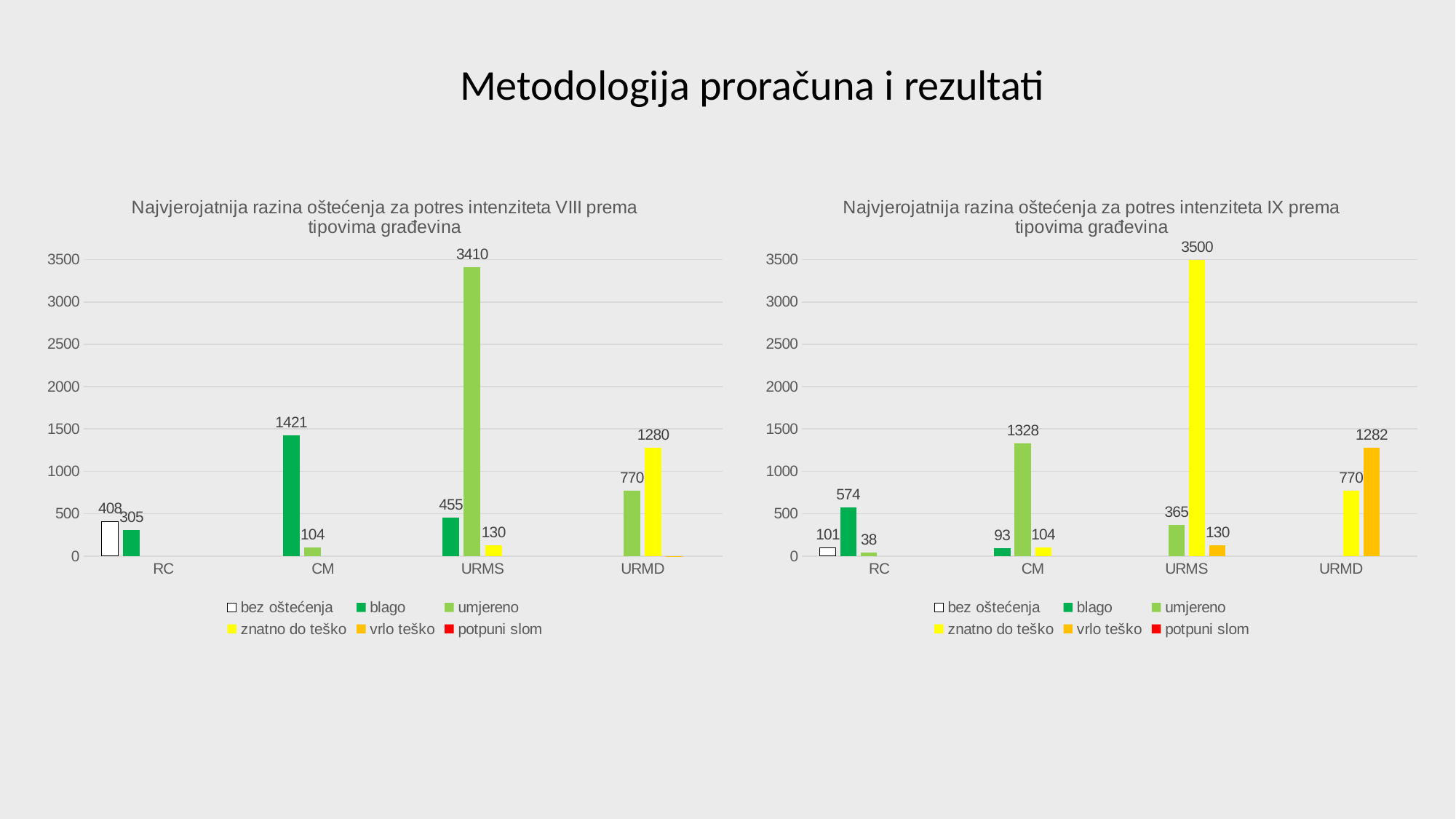
In the chart for intensity VIII (left), is the value of 'blago' for URMS greater or less than 500? less What type of chart is the chart for intensity IX (right)? bar chart How many series does the legend of the chart for intensity VIII (left) list? 6 In the chart for intensity IX (right), which is larger for CM: 'umjereno' or 'znatno do teško'? umjereno In the chart for intensity IX (right), what is the value of 'znatno do teško' for URMS? 3500 In the chart for intensity IX (right), what is the difference between 'blago' and 'bez oštećenja' for RC? 473 In the chart for intensity VIII (left), what is the value of 'umjereno' for URMS? 3410 In the chart for intensity IX (right), what is the value of 'vrlo teško' for URMD? 1282 In the chart for intensity VIII (left), which building type has the highest single bar? URMS In the chart for intensity VIII (left), what is the difference between 'znatno do teško' and 'umjereno' for URMD? 510 In the chart for intensity VIII (left), what is the value of 'blago' for CM? 1421 How many building type categories are shown on the x axis of the chart for intensity IX (right)? 4